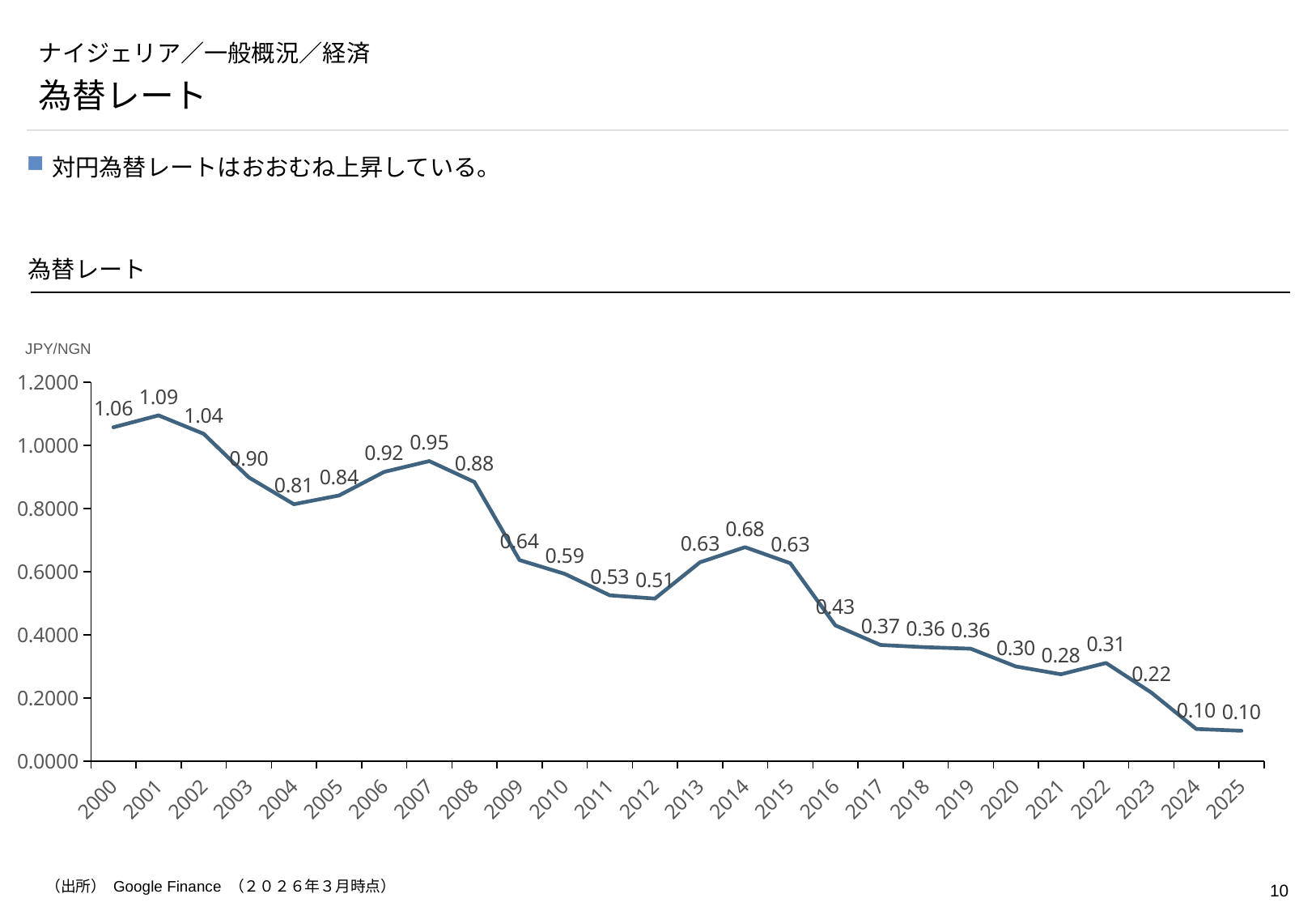
Which year has the highest value on the chart? 2001 What is the value plotted for 2023? 0.22 What unit label is shown above the y axis? JPY/NGN What is the difference between the values for 2000 and 2025? 0.96 Which is larger, the value for 2007 or the value for 2013? 2007 Overall, do the values rise or fall from 2000 to 2025? fall What is the difference between the values for 2008 and 2009? 0.24 What is the lowest value shown on the chart? 0.10 What is the value plotted for 2014? 0.68 What is the JPY/NGN exchange rate value for 2001? 1.09 How many years are plotted on the x axis? 26 What type of chart is shown on the slide? line chart